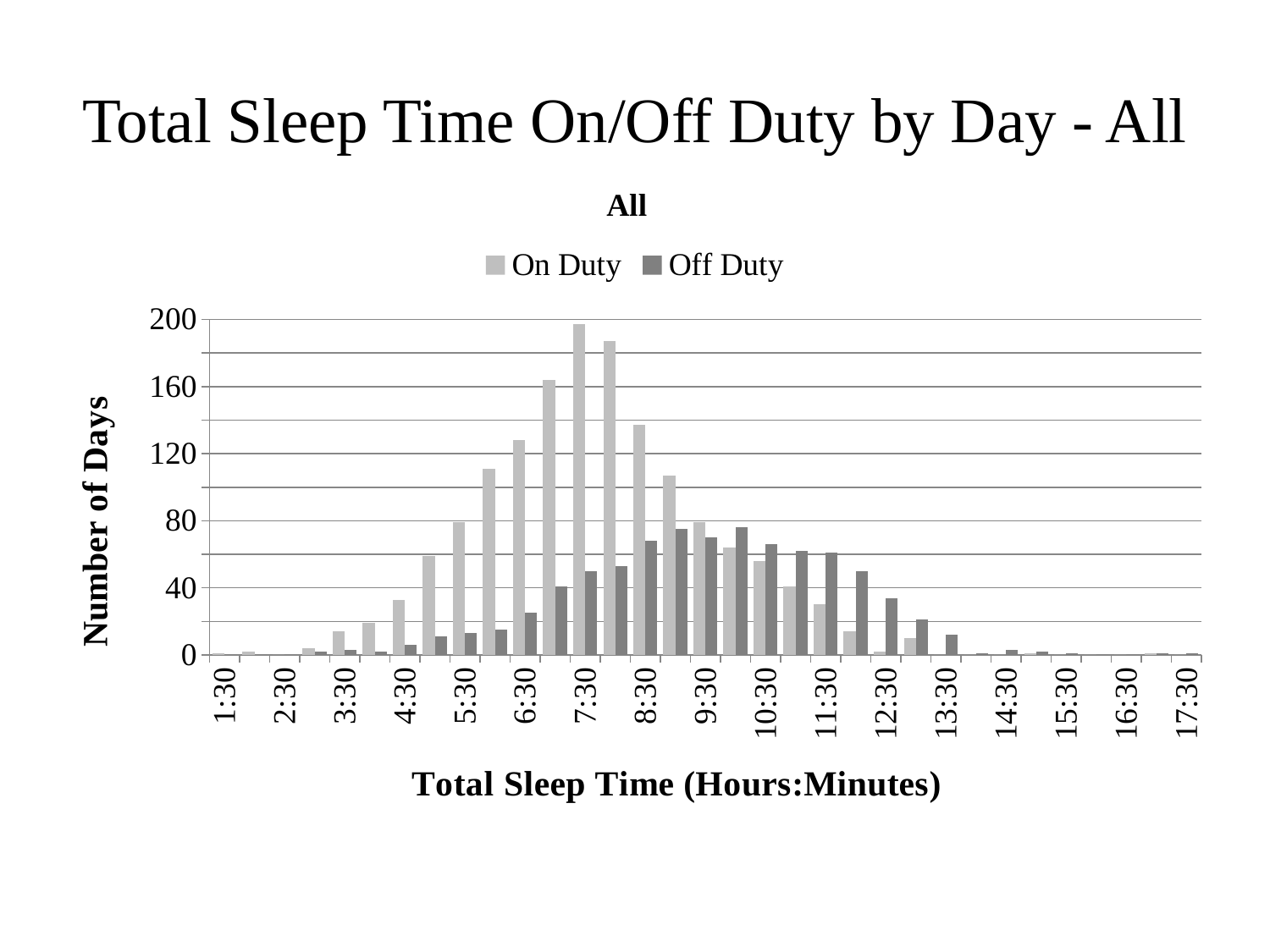
What are the two series named in the legend? On Duty and Off Duty How many series does the legend list? 2 Is the On Duty value at 8:30 greater or less than 120? greater At 11:30, which series has the larger value, On Duty or Off Duty? Off Duty Is the Off Duty value at 6:30 greater or less than 40? less What is the label of the vertical axis? Number of Days What kind of chart is shown on the slide? bar chart Is the Off Duty value at 10:30 greater or less than 40? greater Do the On Duty values rise or fall from 7:30 to 11:30? fall At which labeled sleep time is the On Duty bar highest? 7:30 At 6:30, which series has the larger value, On Duty or Off Duty? On Duty